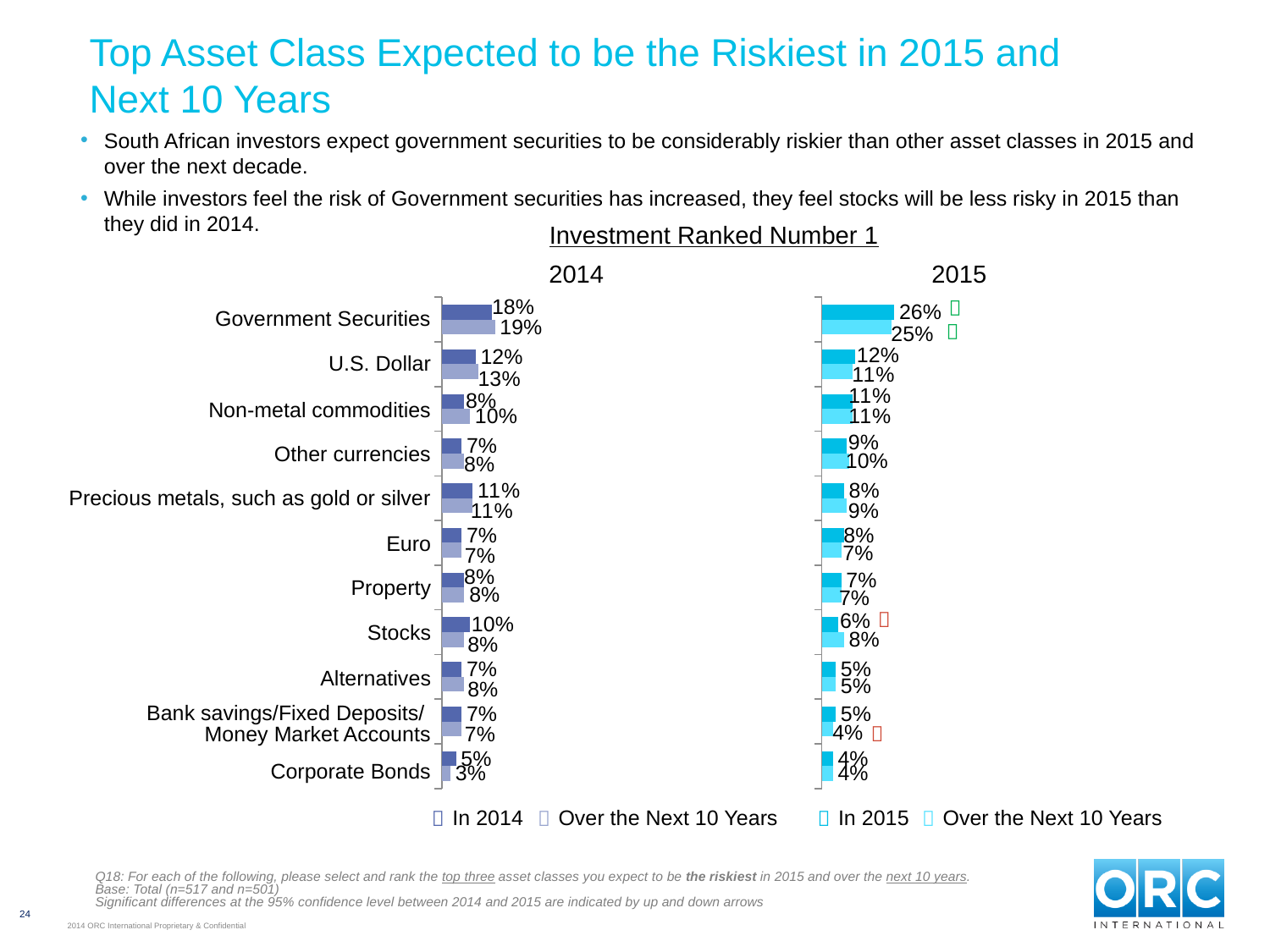
In the 2015 chart, what is the 'In 2015' value for Stocks? 6% What type of chart is used to show the 2014 data? Bar chart In the 2014 chart, which asset class has the lowest 'Over the Next 10 Years' value? Corporate Bonds What is the title shown above the two charts? Investment Ranked Number 1 In the 2014 chart, what percentage ranked Government Securities number 1 for 'In 2014'? 18% In the 2015 chart, what is the 'Over the Next 10 Years' value for Government Securities? 25% How many asset classes are listed in the 2014 chart? 11 In the 2015 chart, which asset class has the highest 'In 2015' value? Government Securities In the 2014 chart, which is larger for Stocks: the 'In 2014' value or the 'Over the Next 10 Years' value? In 2014 In the 2015 chart, what is the difference between the 'In 2015' values for Government Securities and U.S. Dollar? 14 percentage points In the 2014 chart, what is the 'Over the Next 10 Years' value for Corporate Bonds? 3% How many series does the legend of the 2015 chart list? 2